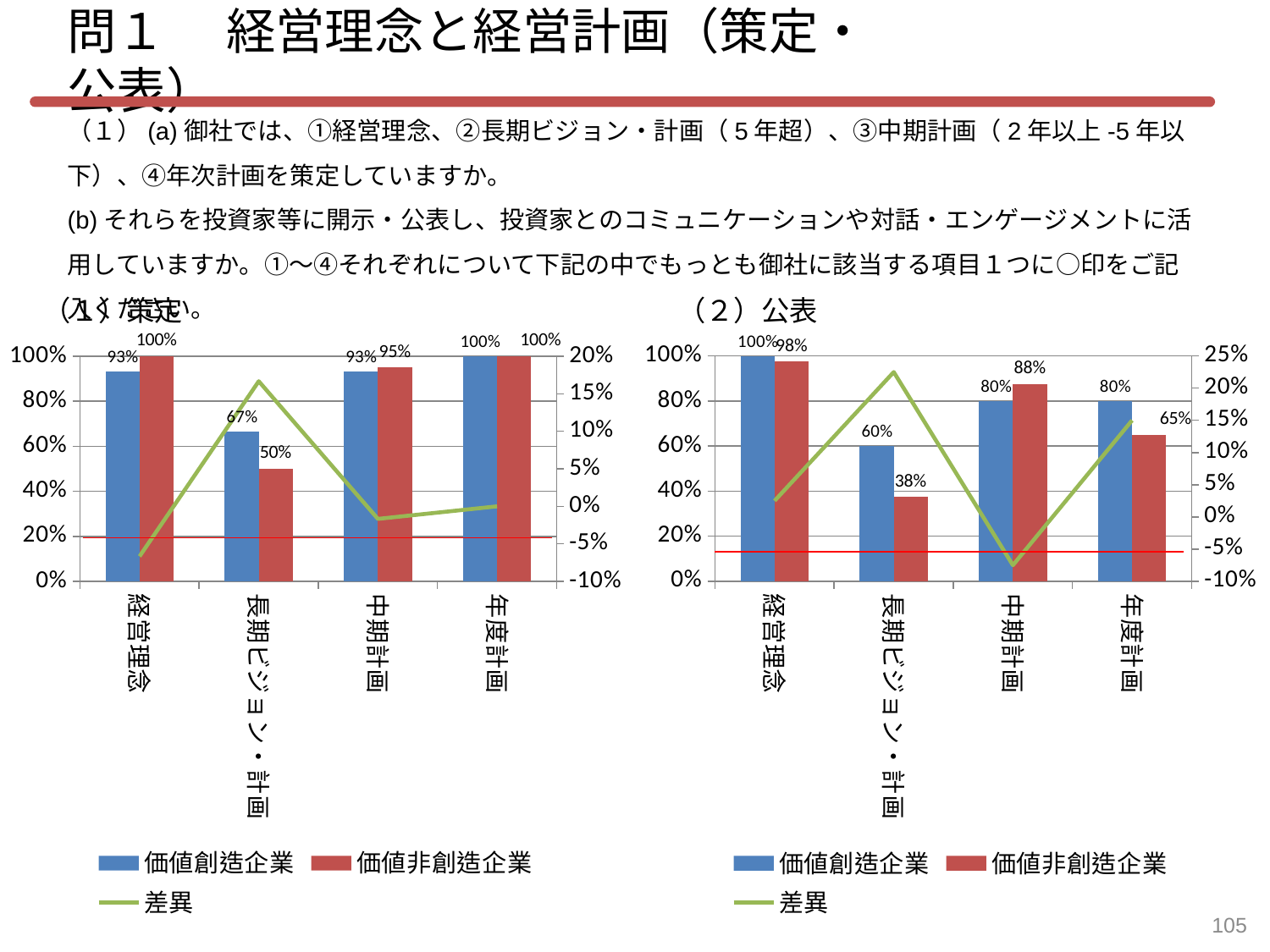
How many categories are shown on the x axis of the （1）策定 chart? 4 In the （2）公表 chart, what is the value for 価値非創造企業 at 長期ビジョン・計画? 38% In the （1）策定 chart, what is the difference between 価値非創造企業 and 価値創造企業 at 経営理念? 7% In the （2）公表 chart, what is the value for 価値創造企業 at 年度計画? 80% How many series does the legend of the （2）公表 chart list? 3 In the （2）公表 chart, which category has the highest value for 価値創造企業? 経営理念 In the （2）公表 chart, which is larger at 中期計画: 価値創造企業 or 価値非創造企業? 価値非創造企業 In the （2）公表 chart, what is the difference between 価値創造企業 and 価値非創造企業 at 長期ビジョン・計画? 22% In the （1）策定 chart, what is the value for 価値創造企業 at 長期ビジョン・計画? 67% In the （1）策定 chart, is the 差異 line value at 長期ビジョン・計画 greater or less than 10%? greater In the （1）策定 chart, which category has the lowest value for 価値非創造企業? 長期ビジョン・計画 In the （1）策定 chart, what is the value for 価値非創造企業 at 中期計画? 95%